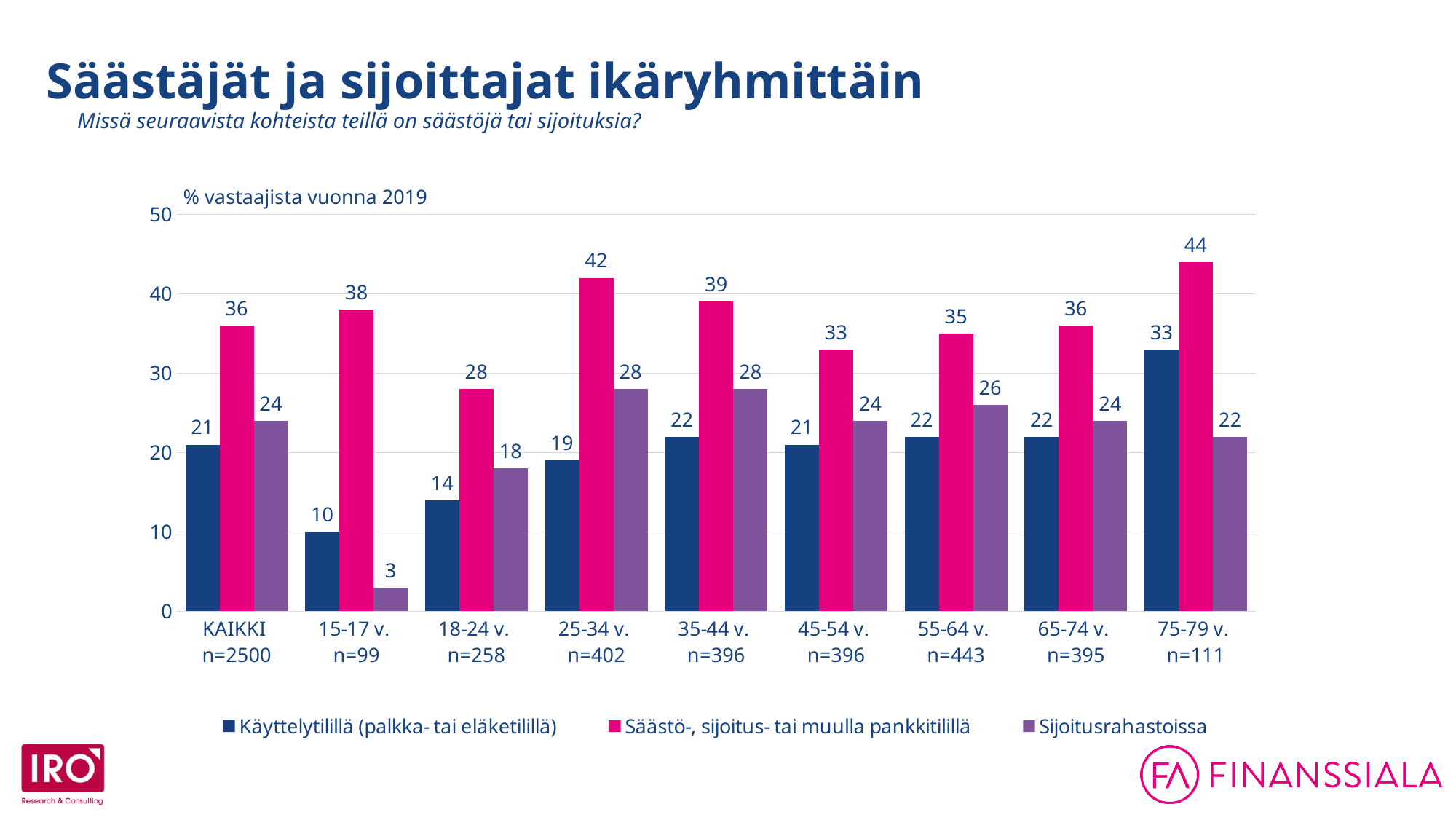
What is the sample size (n) shown for the 55-64 v. group? n=443 Which is larger in the 75-79 v. group: Käyttelytilillä (palkka- tai eläketilillä) or Sijoitusrahastoissa? Käyttelytilillä (palkka- tai eläketilillä) How many series does the legend list? 3 What kind of chart is shown on the slide? Bar chart Which age group has the lowest value for Käyttelytilillä (palkka- tai eläketilillä)? 15-17 v. What is the value for Säästö-, sijoitus- tai muulla pankkitilillä in the 25-34 v. age group? 42 What is the value for Sijoitusrahastoissa in the 15-17 v. age group? 3 What is the axis label shown above the chart? % vastaajista vuonna 2019 What is the value for Käyttelytilillä (palkka- tai eläketilillä) in the KAIKKI group? 21 How many age groups (categories) are shown on the x axis? 9 What is the difference between the Säästö-, sijoitus- tai muulla pankkitilillä value and the Sijoitusrahastoissa value in the 15-17 v. group? 35 Which age group has the highest value for Säästö-, sijoitus- tai muulla pankkitilillä? 75-79 v.